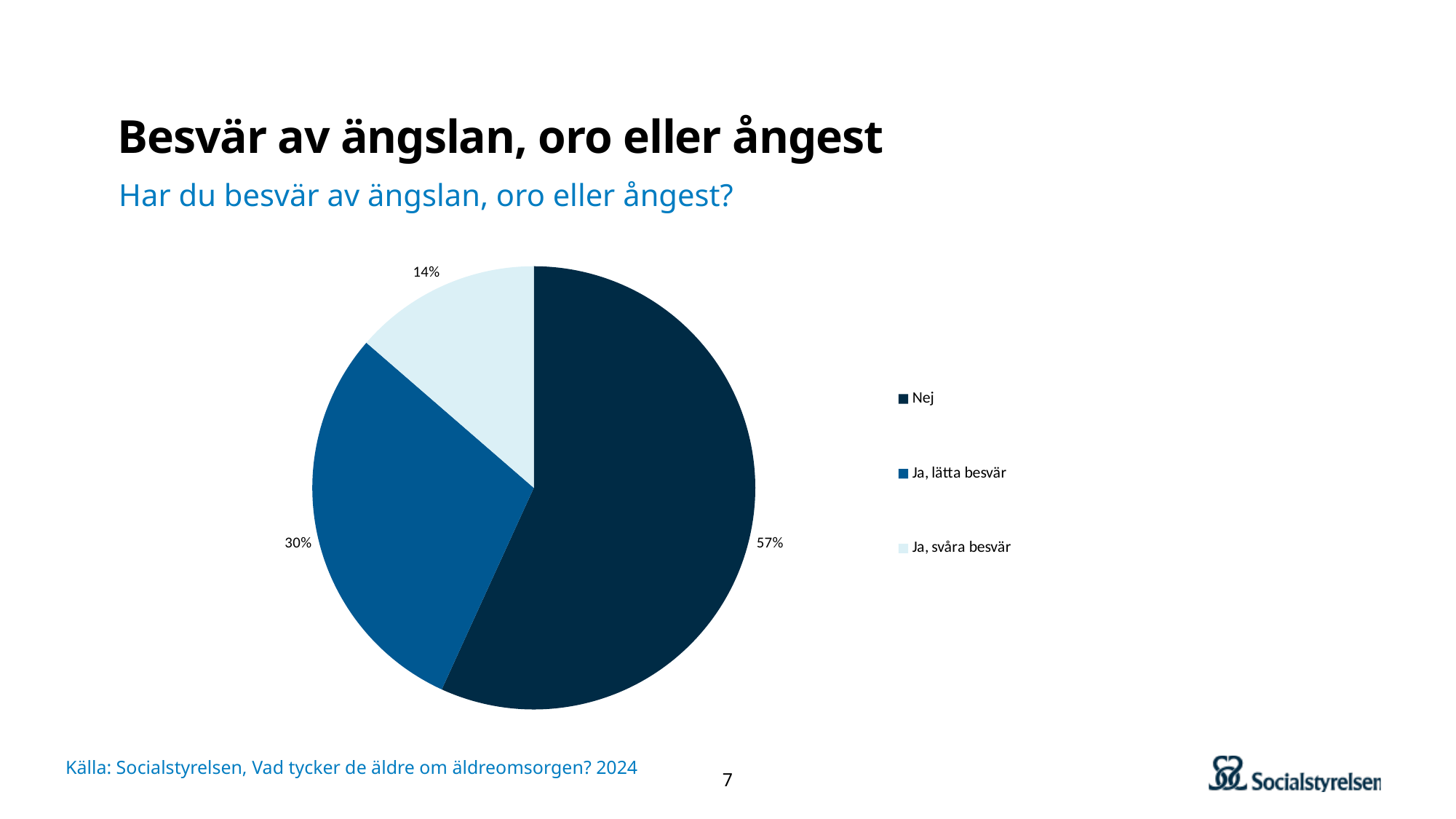
What share of the pie is labelled "Ja, svåra besvär"? 14% What is the difference in percentage points between the "Ja, lätta besvär" slice and the "Ja, svåra besvär" slice? 16 What is the difference in percentage points between the "Nej" slice and the "Ja, lätta besvär" slice? 27 How many entries does the legend list? 3 How many slices does the pie chart have? 3 What question is shown as the chart's subtitle? Har du besvär av ängslan, oro eller ångest? What share of the pie is labelled "Ja, lätta besvär"? 30% What share of the pie is labelled "Nej"? 57% Which category has the smallest slice of the pie? Ja, svåra besvär Which slice is larger, "Ja, lätta besvär" or "Ja, svåra besvär"? Ja, lätta besvär What kind of chart is shown on the slide? pie chart Which category has the largest slice of the pie? Nej